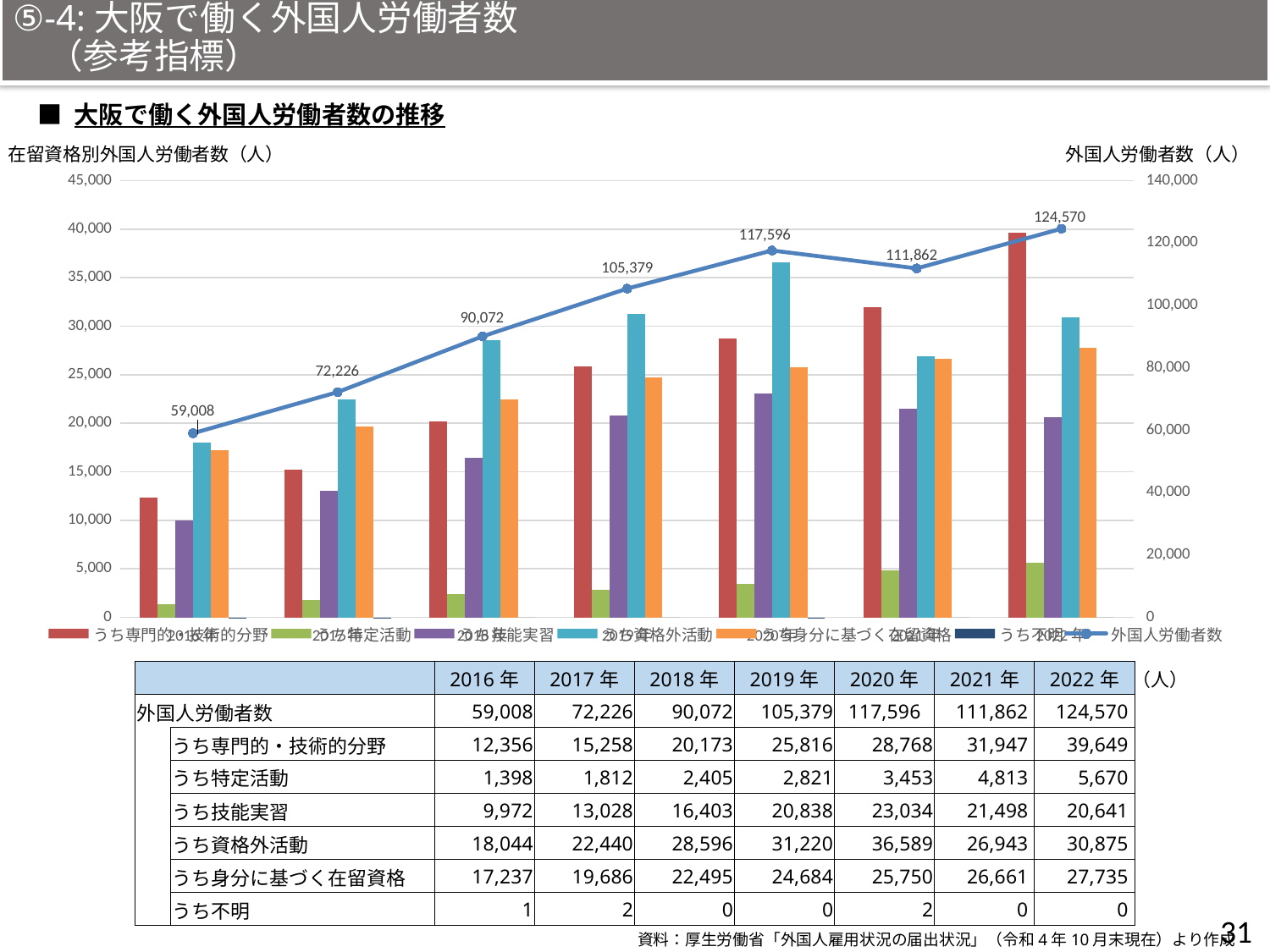
What kind of chart is shown on the slide? Combined bar and line chart What is the difference in 外国人労働者数 between 2017年 and 2016年? 13,218 How many years are shown on the x axis of the chart? 7 In which year is 外国人労働者数 highest? 2022年 What is the value of 外国人労働者数 for 2016年? 59,008 Which year has the larger 外国人労働者数, 2020年 or 2021年? 2020年 How many series does the chart legend list? 7 Does 外国人労働者数 rise or fall from 2016年 to 2020年? rise Is the bar value for うち専門的・技術的分野 in 2022年 greater or less than 35,000? greater What is the value of 外国人労働者数 for 2019年? 105,379 What is the difference in 外国人労働者数 between 2022年 and 2021年? 12,708 In which year is 外国人労働者数 lowest? 2016年